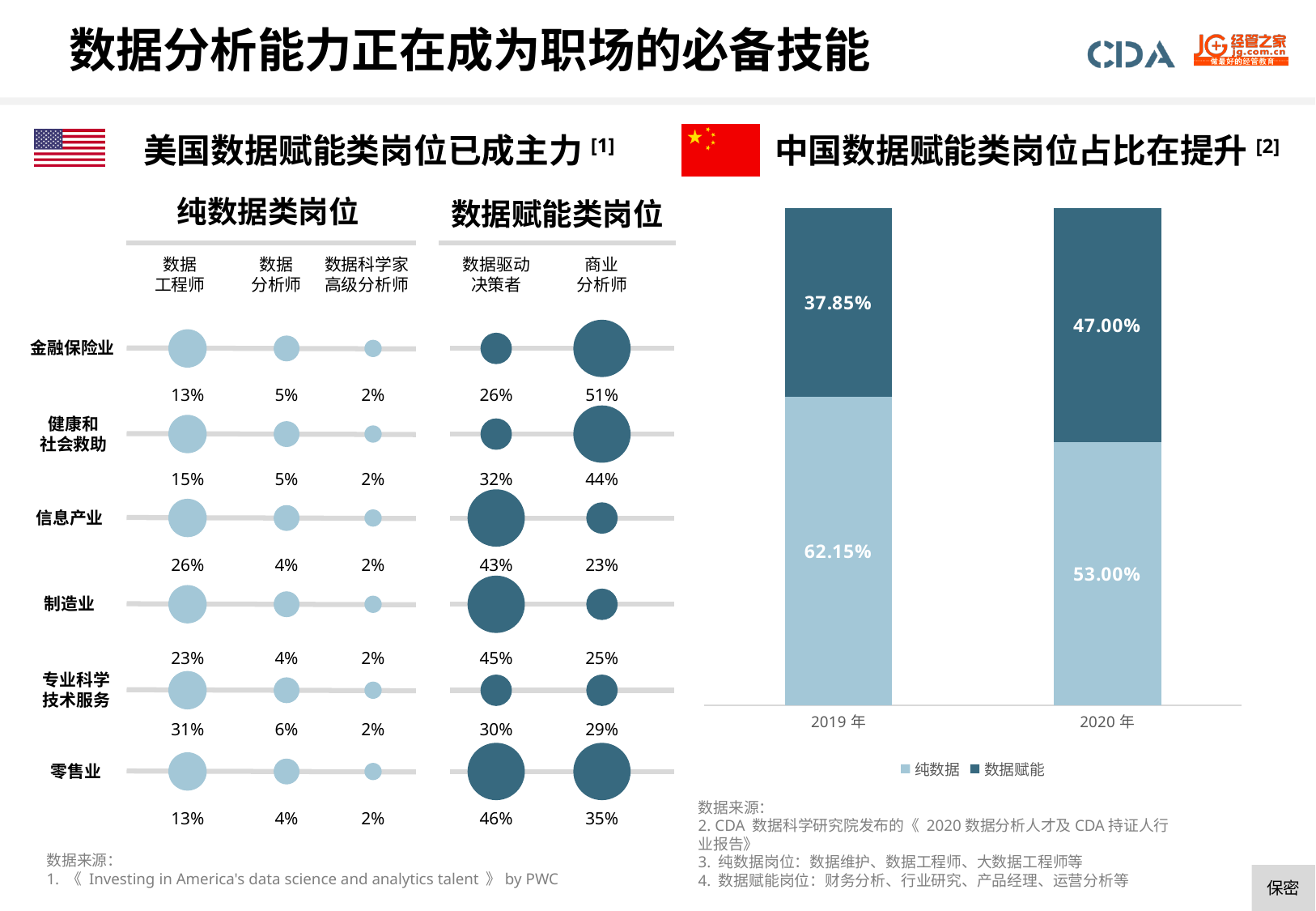
In the right chart titled 中国数据赋能类岗位占比在提升, what is the value of 纯数据 for 2019 年? 62.15% In the right chart titled 中国数据赋能类岗位占比在提升, what kind of chart is it? stacked bar chart In the left chart titled 美国数据赋能类岗位已成主力, what is the value for 数据驱动决策者 in 零售业? 46% In the left chart titled 美国数据赋能类岗位已成主力, what is the difference between 数据驱动决策者 and 商业分析师 in 信息产业? 20% In the left chart titled 美国数据赋能类岗位已成主力, what is the value for 商业分析师 in 金融保险业? 51% In the right chart titled 中国数据赋能类岗位占比在提升, what is the value of 数据赋能 for 2020 年? 47.00% In the right chart titled 中国数据赋能类岗位占比在提升, does the 数据赋能 share rise or fall from 2019 年 to 2020 年? rise In the left chart titled 美国数据赋能类岗位已成主力, how many industries are listed? 6 In the right chart titled 中国数据赋能类岗位占比在提升, by how many percentage points did 数据赋能 change from 2019 年 to 2020 年? 9.15 percentage points In the right chart titled 中国数据赋能类岗位占比在提升, how many series does the legend list? 2 In the left chart titled 美国数据赋能类岗位已成主力, which industry has the highest value for 数据工程师? 专业科学技术服务 In the right chart titled 中国数据赋能类岗位占比在提升, which series is larger in 2020 年, 纯数据 or 数据赋能? 纯数据